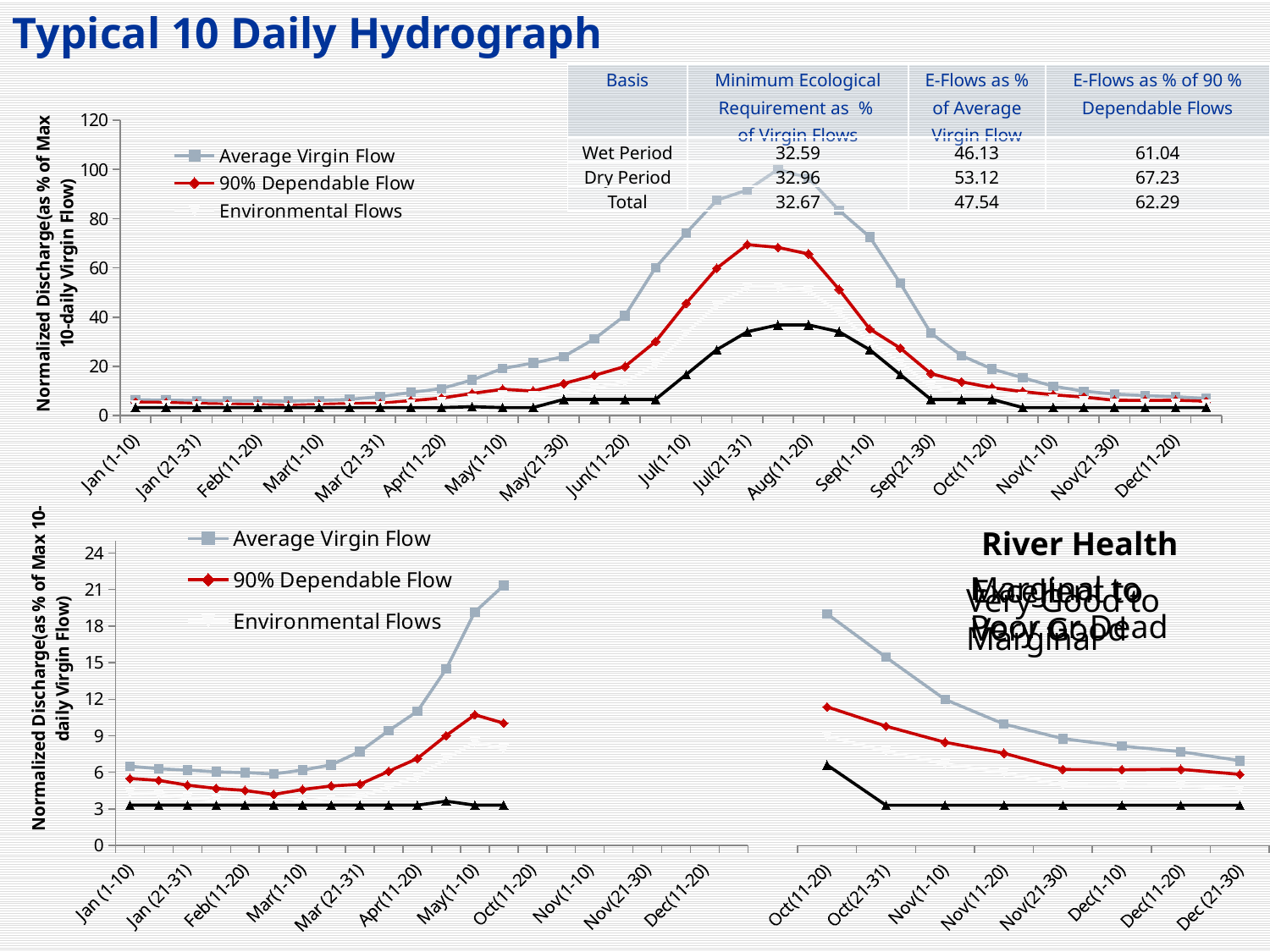
In the top chart, is the value of Average Virgin Flow at Jul(21-31) greater or less than 80? greater How many series does the legend of the top chart list? 3 In the bottom-right chart, is the value of Average Virgin Flow at Oct(11-20) greater or less than 18? greater In the top chart, is the value of 90% Dependable Flow at Jul(21-31) greater or less than 60? greater In the top chart, which series reaches the highest value at Aug(1-10)? Average Virgin Flow In the top chart, does the Average Virgin Flow rise or fall from Aug(1-10) to Dec(11-20)? fall What is the title of the slide containing the charts? Typical 10 Daily Hydrograph What kind of chart is the top chart on the slide? line chart In the bottom-right chart, does the Average Virgin Flow rise or fall from Oct(11-20) to Dec(21-30)? fall